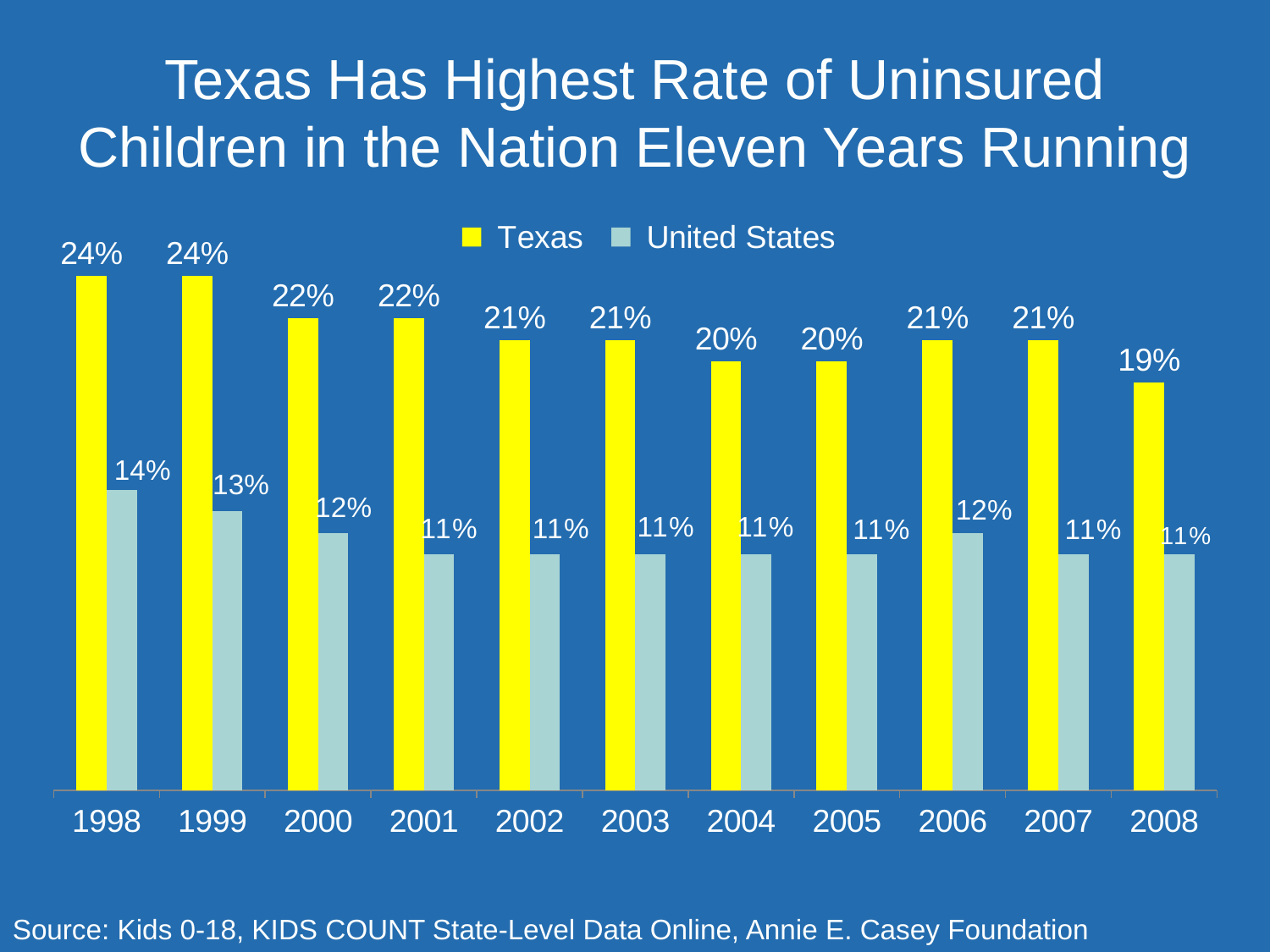
In which year is the United States value highest? 1998 What is the difference between the Texas value in 1998 and the Texas value in 2008? 5% What is the Texas value for 2003? 21% What is the Texas value for 2008? 19% What is the United States value for 2006? 12% How many series does the legend list? 2 What is the United States value for 1998? 14% What is the difference between the Texas and United States values in 2001? 11% In which year is the Texas value lowest? 2008 How many years are shown on the x axis? 11 Which is larger, the Texas value for 2004 or the Texas value for 2000? Texas value for 2000 What kind of chart is shown on the slide? Bar chart